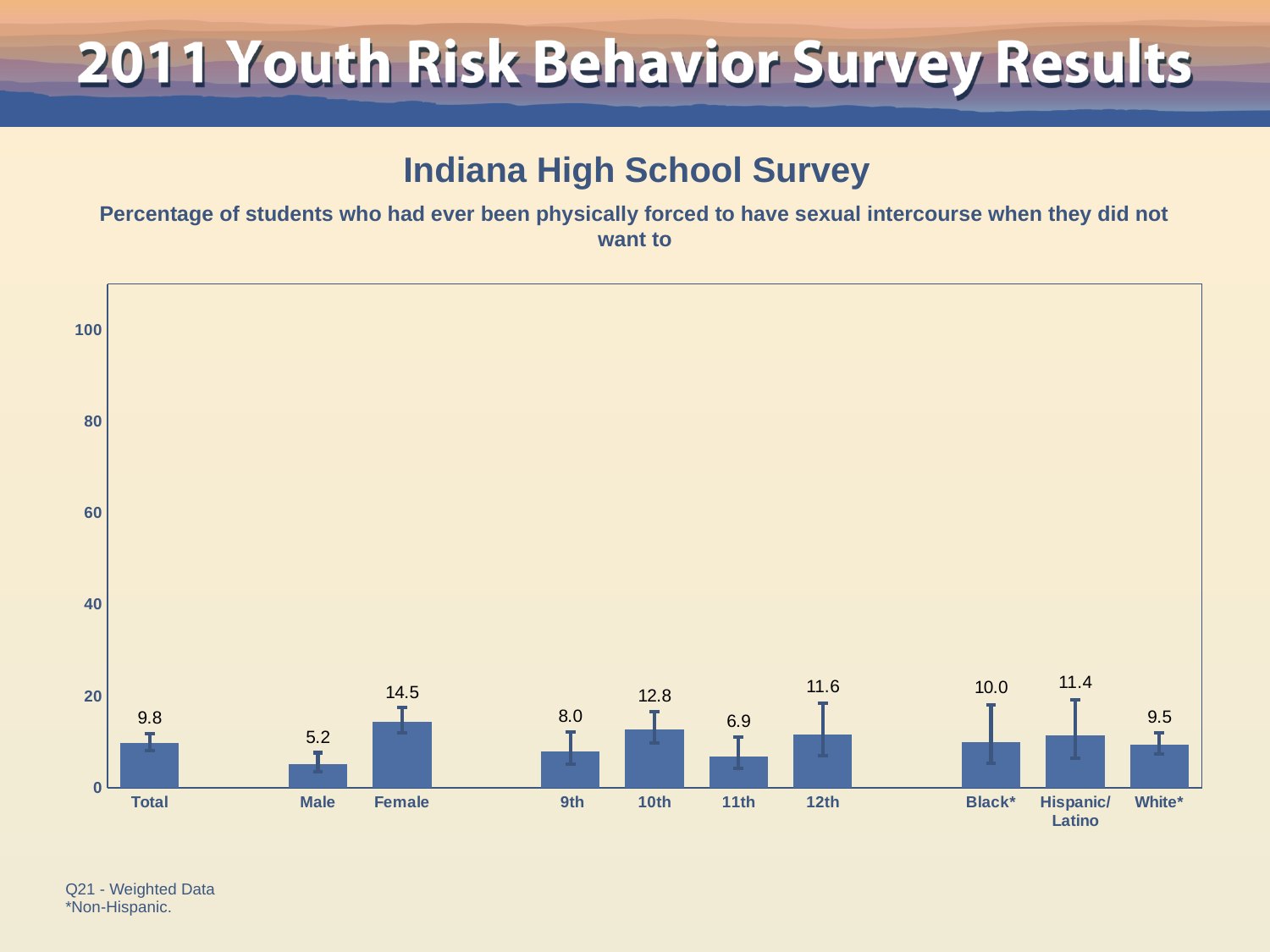
What is the value for Female? 14.5 How many categories are shown on the x axis? 10 Which category has the highest value? Female What is the difference between the Female and Male values? 9.3 Which is larger, the value for 10th grade or the value for 12th grade? 10th Which category has the lowest value? Male What is the value for 11th grade? 6.9 What is the highest value shown on the y axis? 100 What is the value for Hispanic/Latino? 11.4 Is the value for Female greater or less than 20? less What is the difference between the Black* and White* values? 0.5 What kind of chart is shown? bar chart